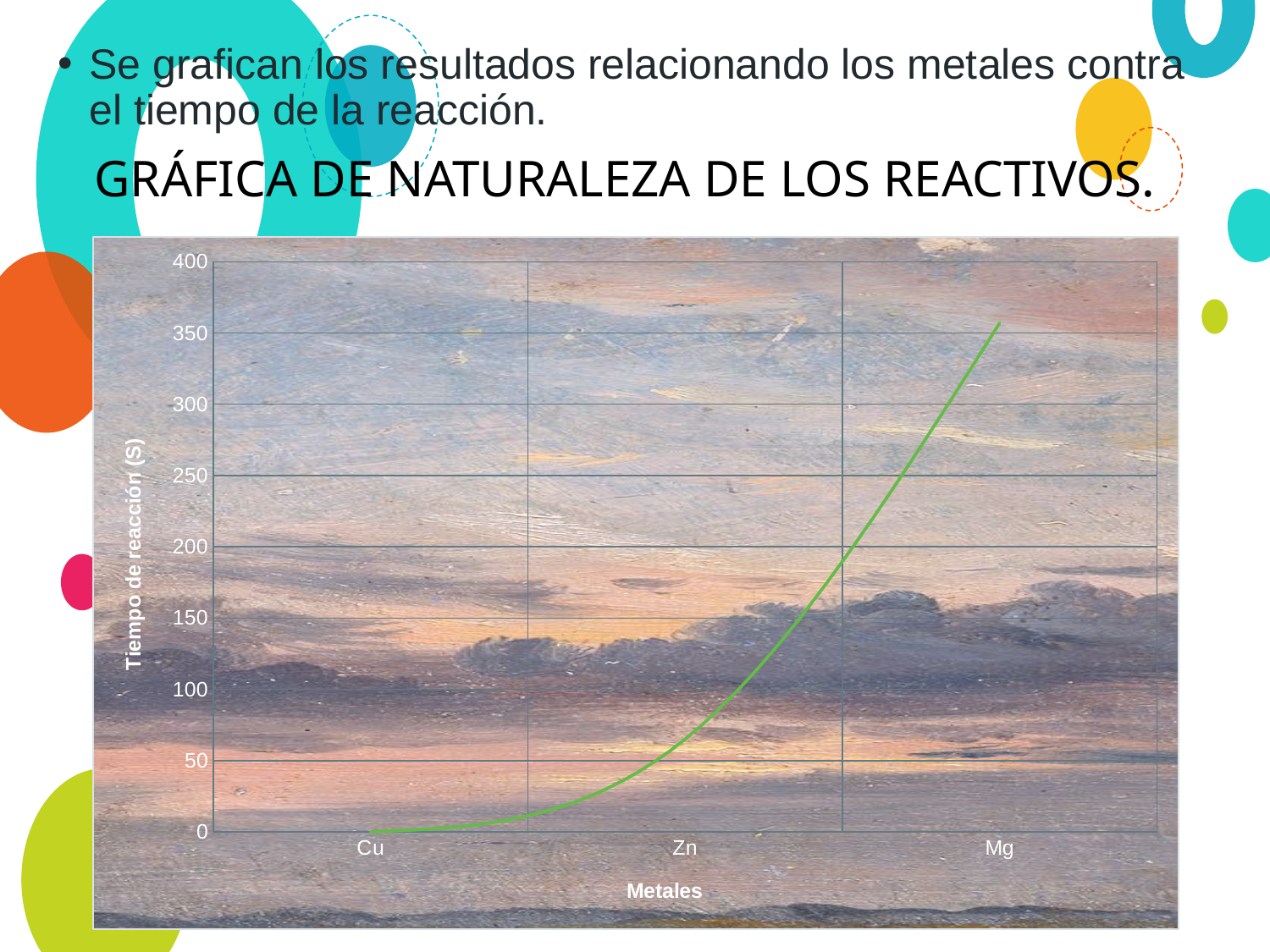
Is the reaction time for Mg greater or less than 300? greater Which metal has the lowest reaction time? Cu How many metals are plotted along the x axis? 3 Is the reaction time for Zn greater or less than 100? less Which metal has the highest reaction time? Mg Which has a larger reaction time, Zn or Mg? Mg What is the label of the y axis? Tiempo de reacción (S) Which has a larger reaction time, Cu or Mg? Mg Do the reaction time values rise or fall from Cu to Mg along the x axis? rise Is the reaction time for Cu greater or less than 50? less What is the label of the x axis? Metales What kind of chart is shown on the slide? line chart